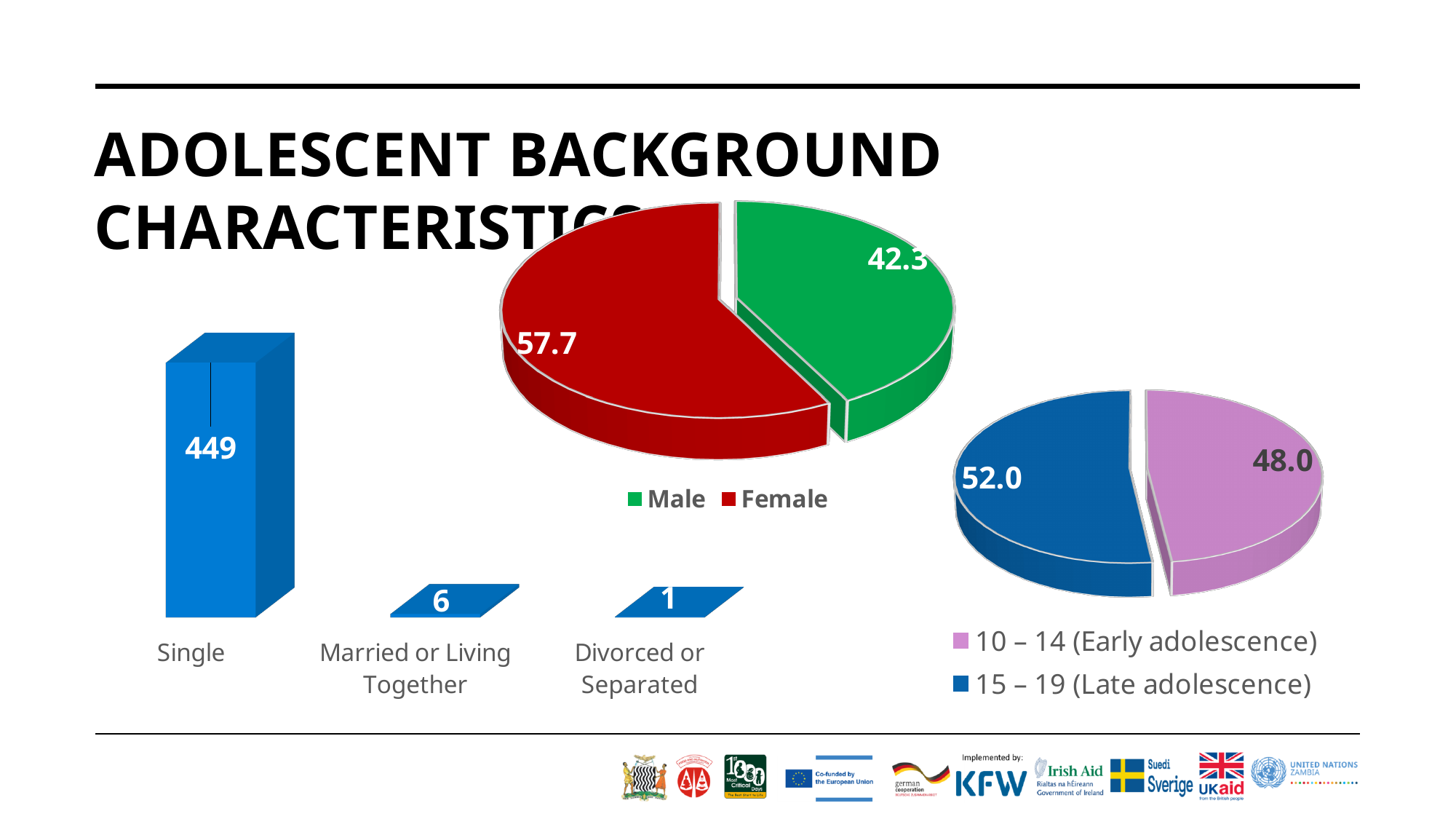
How many entries does the legend of the pie chart on the right of the slide list? 2 How many categories does the bar chart on the left of the slide show? 3 What kind of chart is the chart on the left of the slide? Bar chart In the pie chart on the right of the slide, what is the difference between the values for 15 – 19 (Late adolescence) and 10 – 14 (Early adolescence)? 4.0 In the bar chart on the left of the slide, what is the value for Single? 449 In the pie chart in the middle of the slide, which is larger, Male or Female? Female In the pie chart in the middle of the slide, what is the value for Female? 57.7 In the bar chart on the left of the slide, which category has the lowest value? Divorced or Separated In the pie chart on the right of the slide, what is the value for 10 – 14 (Early adolescence)? 48.0 In the bar chart on the left of the slide, what is the value for Married or Living Together? 6 In the bar chart on the left of the slide, what is the difference between the values for Single and Married or Living Together? 443 In the bar chart on the left of the slide, which category has the highest value? Single